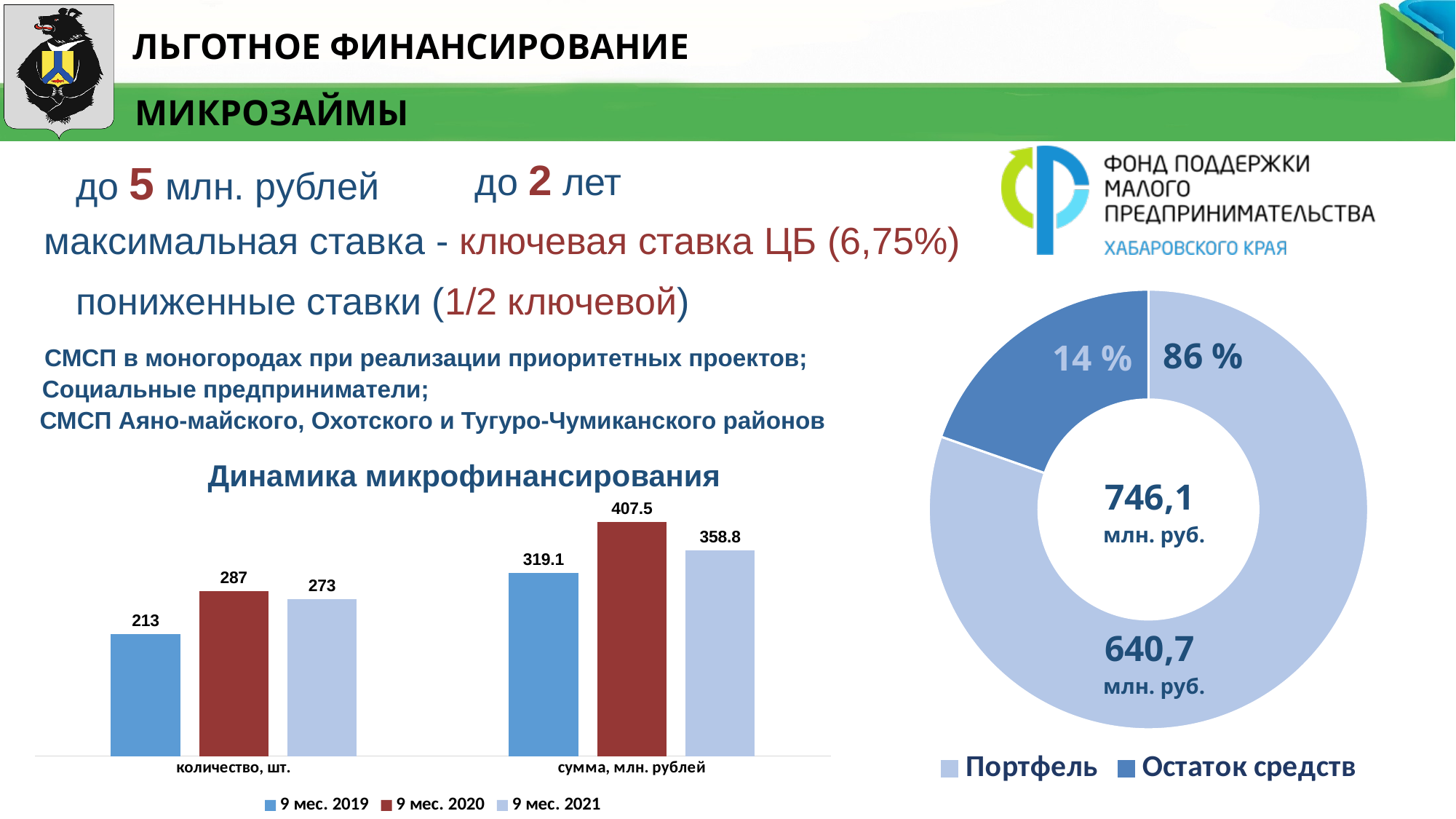
In the doughnut chart on the right, what share is shown for 'Остаток средств'? 14 % In the chart 'Динамика микрофинансирования', which is larger for 'количество, шт.': '9 мес. 2021' or '9 мес. 2019'? 9 мес. 2021 In the chart 'Динамика микрофинансирования', what is the difference between the 'количество, шт.' values for '9 мес. 2020' and '9 мес. 2021'? 14 In the chart 'Динамика микрофинансирования', what is the value for 'количество, шт.' in the series '9 мес. 2019'? 213 In the chart 'Динамика микрофинансирования', what is the value for 'сумма, млн. рублей' in the series '9 мес. 2021'? 358.8 In the chart 'Динамика микрофинансирования', what is the difference between the 'сумма, млн. рублей' values for '9 мес. 2020' and '9 мес. 2019'? 88.4 In the chart 'Динамика микрофинансирования', which series has the lowest value for 'количество, шт.'? 9 мес. 2019 How many series does the legend of the chart 'Динамика микрофинансирования' list? 3 In the doughnut chart on the right, what share is shown for 'Портфель'? 86 % In the chart 'Динамика микрофинансирования', what is the value for 'количество, шт.' in the series '9 мес. 2020'? 287 What kind of chart is 'Динамика микрофинансирования'? Bar chart In the chart 'Динамика микрофинансирования', which series has the highest value for 'сумма, млн. рублей'? 9 мес. 2020